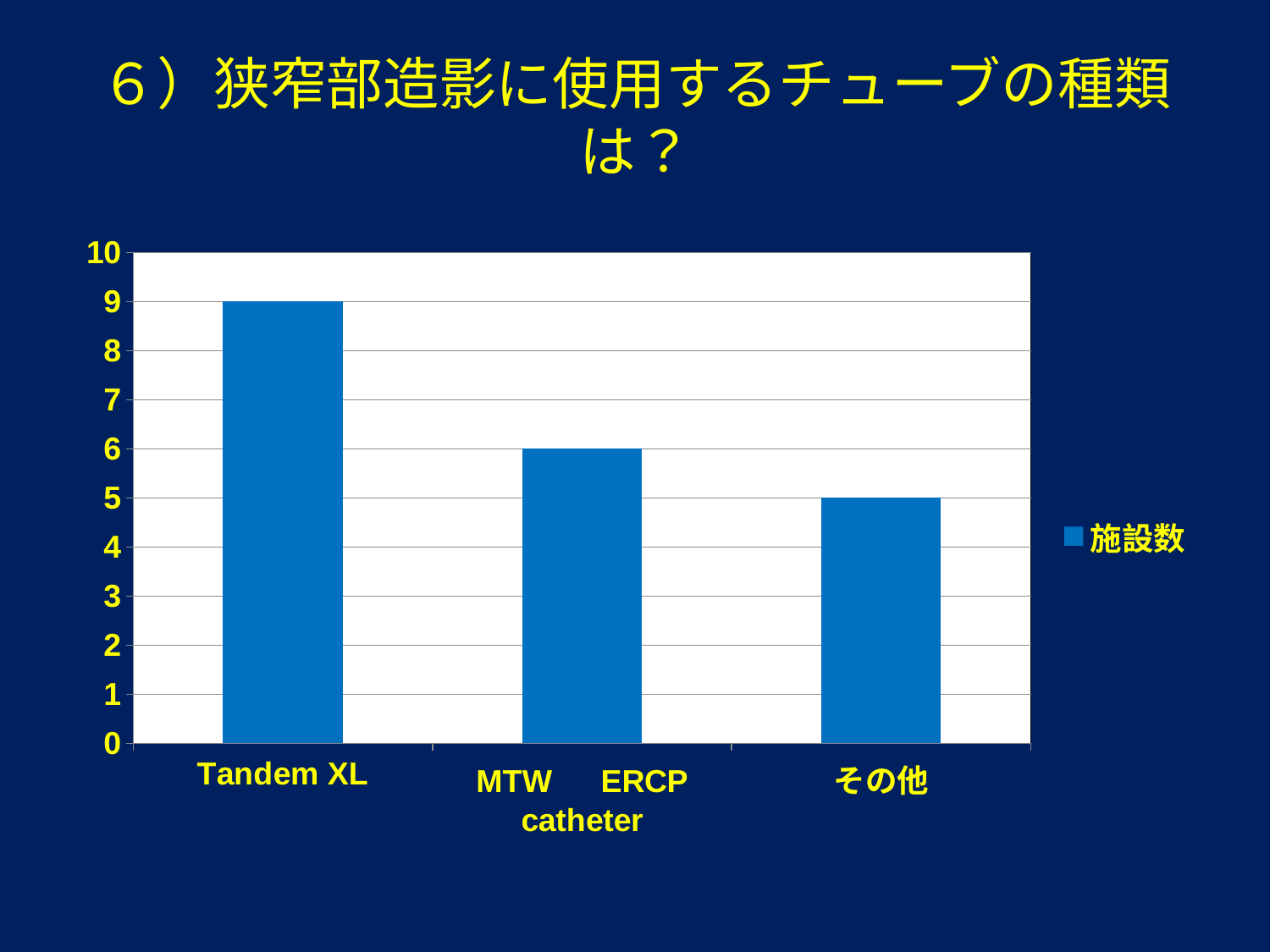
How many categories are shown on the x axis? 3 Which category has the lowest value? その他 What kind of chart is shown on the slide? bar chart Which category has the highest value? Tandem XL What is the value for その他? 5 Which is larger, the value for Tandem XL or the value for その他? Tandem XL What is the value for MTW ERCP catheter? 6 Is the value for Tandem XL greater or less than 8? greater What is the difference between the values for Tandem XL and MTW ERCP catheter? 3 What is the value for Tandem XL? 9 What is the difference between the values for MTW ERCP catheter and その他? 1 What is the legend entry for the series? 施設数